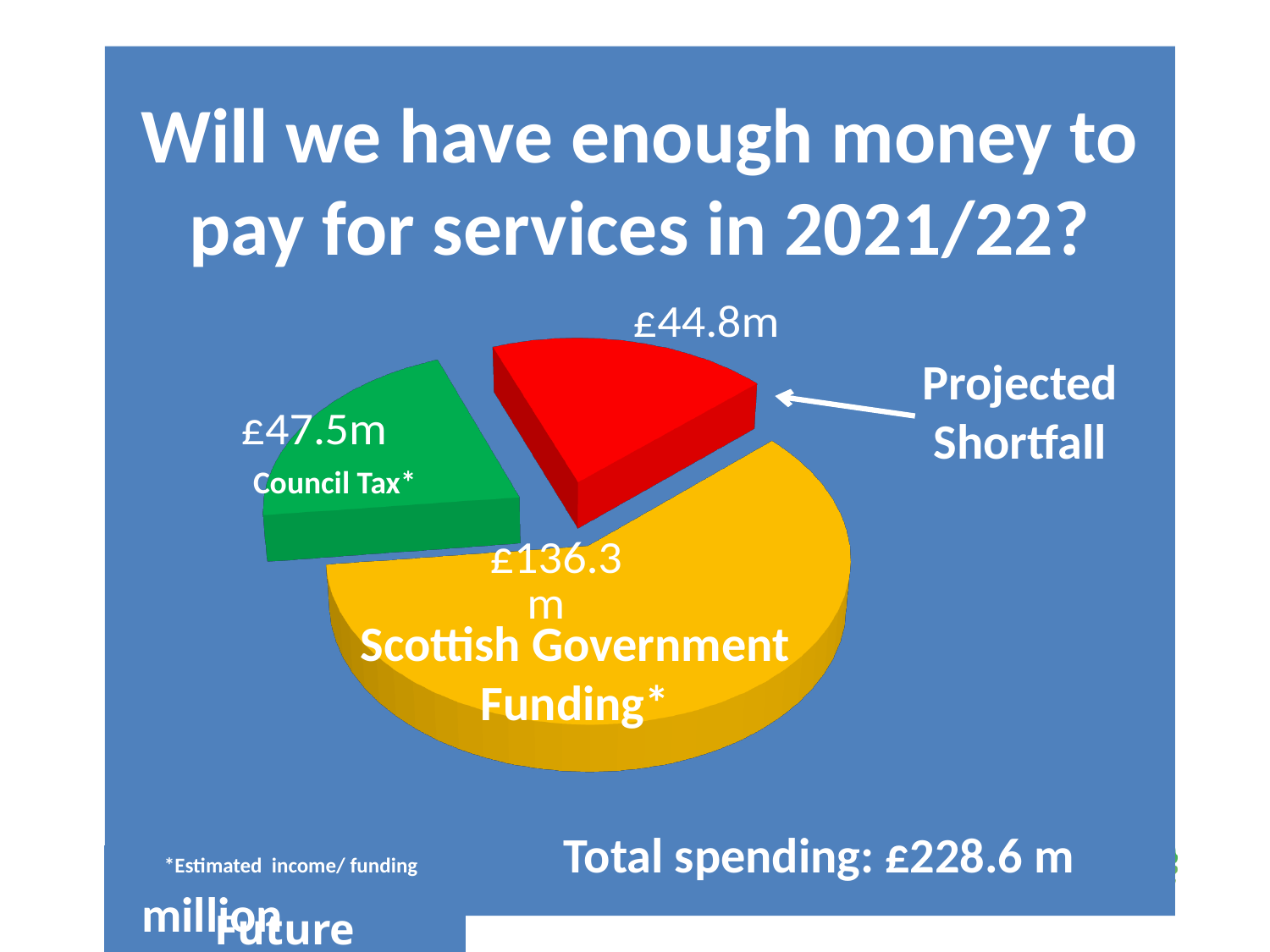
What is the value of the Scottish Government Funding* slice? £136.3m Which slice of the pie chart is the largest? Scottish Government Funding* What is the difference between Scottish Government Funding* and Council Tax*? £88.8m What is the value of the Projected Shortfall slice? £44.8m How many slices does the pie chart have? 3 What is the total of the three slices in the pie chart? £228.6m What kind of chart is shown on the slide? pie chart What is the value of the Council Tax* slice? £47.5m Which is larger, Council Tax* or Projected Shortfall? Council Tax* Which slice of the pie chart is coloured red? Projected Shortfall Which slice of the pie chart is the smallest? Projected Shortfall What share of the total spending does Scottish Government Funding* represent? 59.6%